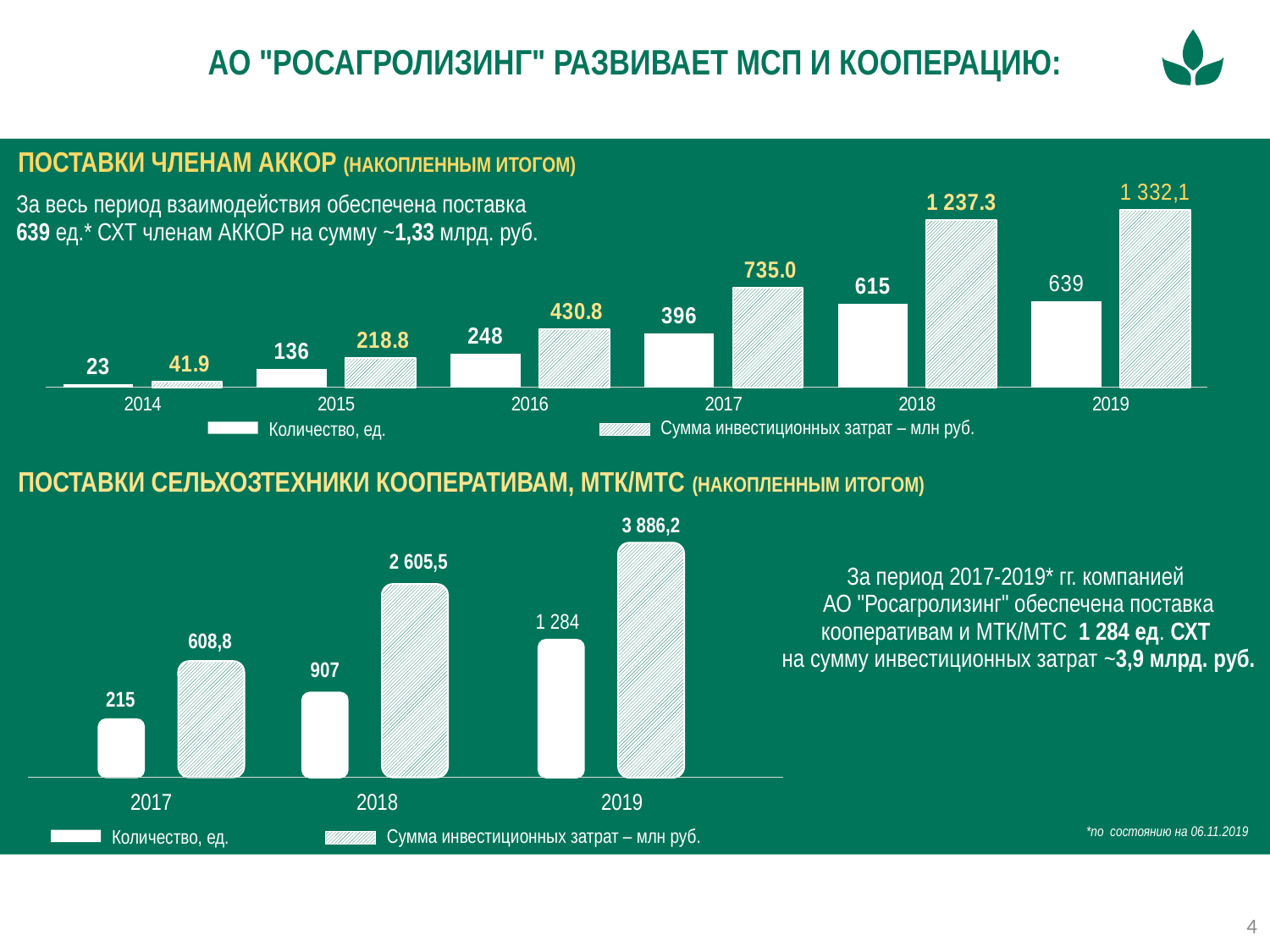
In the bottom chart (ПОСТАВКИ СЕЛЬХОЗТЕХНИКИ КООПЕРАТИВАМ, МТК/МТС), how many series does the legend list? 2 In the top chart (ПОСТАВКИ ЧЛЕНАМ АККОР), how many years are shown on the x axis? 6 In the bottom chart (ПОСТАВКИ СЕЛЬХОЗТЕХНИКИ КООПЕРАТИВАМ, МТК/МТС), what is the Сумма инвестиционных затрат for 2019? 3 886,2 In the top chart (ПОСТАВКИ ЧЛЕНАМ АККОР), which year has the lowest Количество, ед.? 2014 In the bottom chart (ПОСТАВКИ СЕЛЬХОЗТЕХНИКИ КООПЕРАТИВАМ, МТК/МТС), what is the Количество, ед. for 2018? 907 In the top chart (ПОСТАВКИ ЧЛЕНАМ АККОР), which year has the highest Сумма инвестиционных затрат? 2019 In the top chart (ПОСТАВКИ ЧЛЕНАМ АККОР), does Количество, ед. rise or fall from 2014 to 2019? rise In the bottom chart (ПОСТАВКИ СЕЛЬХОЗТЕХНИКИ КООПЕРАТИВАМ, МТК/МТС), which is larger: Количество, ед. in 2017 or in 2019? 2019 In the top chart (ПОСТАВКИ ЧЛЕНАМ АККОР), what is the difference in Количество, ед. between 2018 and 2017? 219 In the top chart (ПОСТАВКИ ЧЛЕНАМ АККОР), what is the Сумма инвестиционных затрат for 2018? 1 237.3 In the top chart (ПОСТАВКИ ЧЛЕНАМ АККОР), what is the value of Количество, ед. for 2017? 396 What type of chart is the bottom chart (ПОСТАВКИ СЕЛЬХОЗТЕХНИКИ КООПЕРАТИВАМ, МТК/МТС)? bar chart